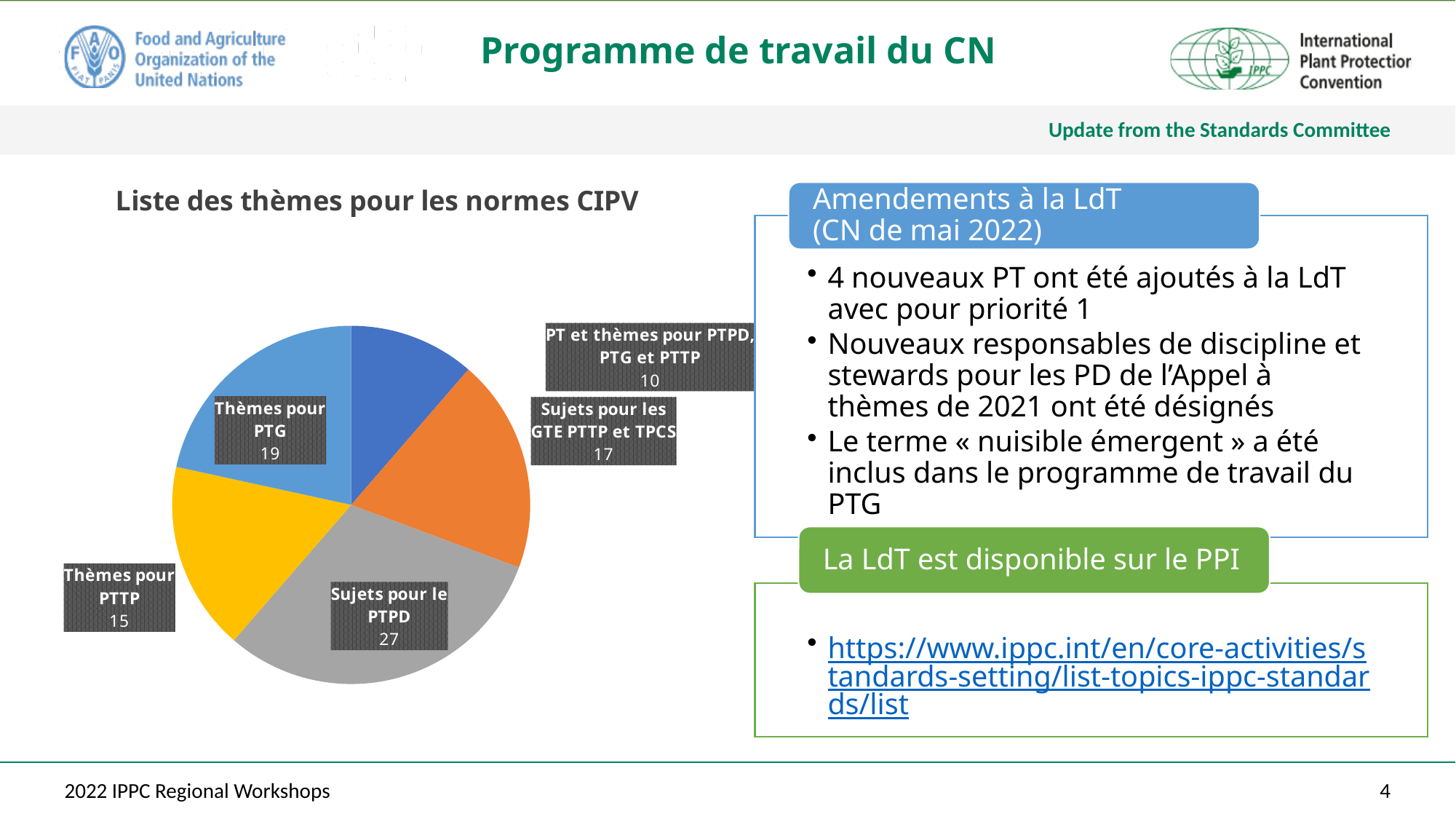
Which is larger in the pie chart: 'Thèmes pour PTG' or 'Sujets pour les GTE PTTP et TPCS'? Thèmes pour PTG What is the value for 'Sujets pour les GTE PTTP et TPCS' in the pie chart? 17 What is the value for 'Thèmes pour PTTP' in the pie chart? 15 What kind of chart is shown under the title 'Liste des thèmes pour les normes CIPV'? Pie chart What is the value for 'PT et thèmes pour PTPD, PTG et PTTP' in the pie chart? 10 How many slices does the pie chart have? 5 What is the value for 'Sujets pour le PTPD' in the pie chart? 27 What is the value for 'Thèmes pour PTG' in the pie chart? 19 Which category has the smallest slice in the pie chart? PT et thèmes pour PTPD, PTG et PTTP Which category has the largest slice in the pie chart? Sujets pour le PTPD What is the title of the pie chart? Liste des thèmes pour les normes CIPV What is the difference between the values for 'Sujets pour le PTPD' and 'Thèmes pour PTTP'? 12